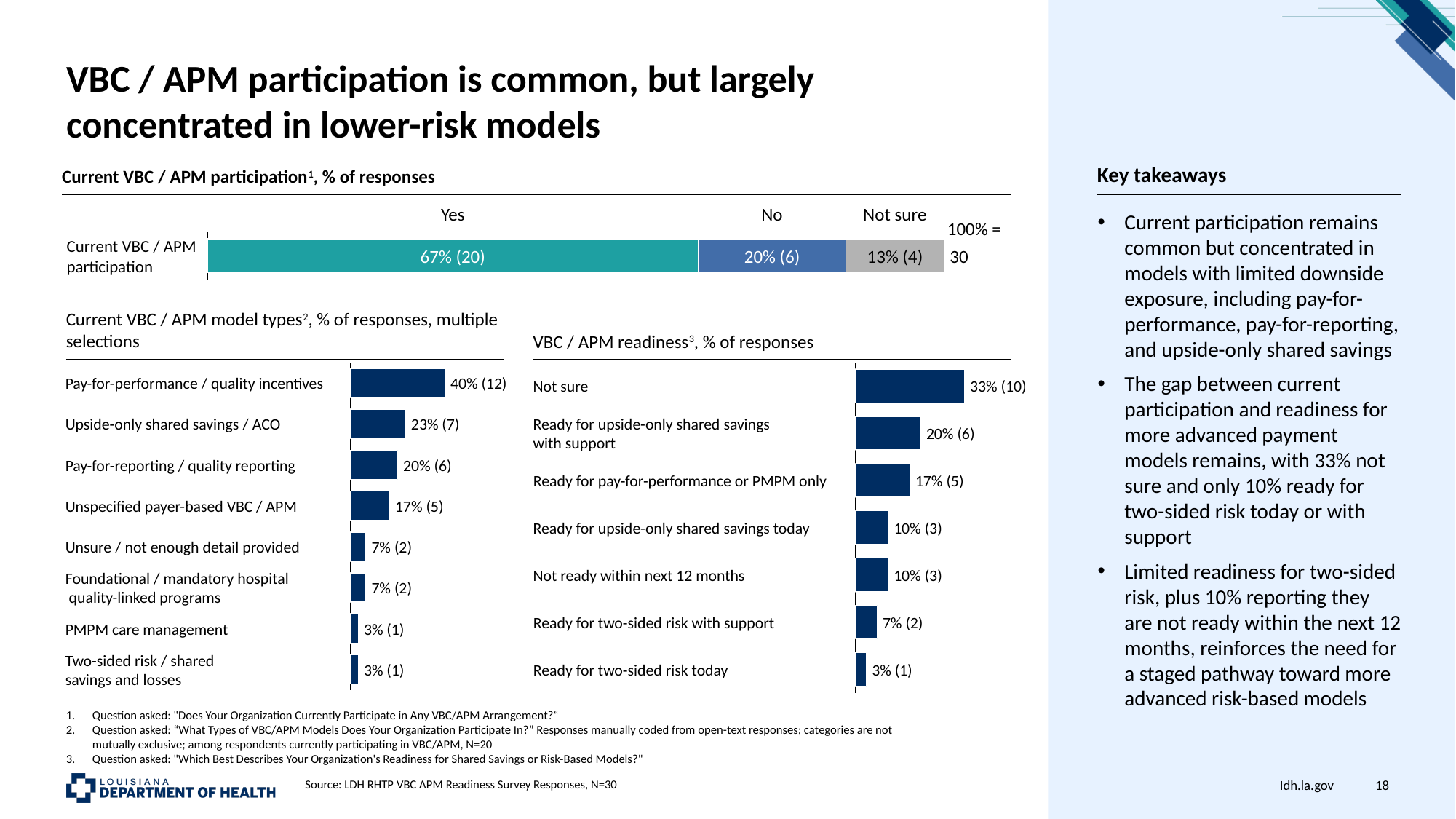
In the 'VBC / APM readiness' chart, which is larger: 'Not sure' or 'Ready for upside-only shared savings with support'? Not sure In the 'Current VBC / APM participation' chart, what is the value for 'Not sure'? 13% (4) In the 'Current VBC / APM model types' chart, which category has the highest value? Pay-for-performance / quality incentives In the 'Current VBC / APM participation' chart, what total does the bar add up to, as shown by the '100% =' label? 30 What type of chart is the 'VBC / APM readiness' chart? Bar chart In the 'Current VBC / APM participation' chart, what percentage of responses answered Yes? 67% (20) In the 'Current VBC / APM model types' chart, what is the value for 'Pay-for-reporting / quality reporting'? 20% (6) In the 'Current VBC / APM model types' chart, what is the difference in percentage points between 'Pay-for-performance / quality incentives' and 'Upside-only shared savings / ACO'? 17 percentage points In the 'Current VBC / APM participation' chart, how many segments make up the stacked bar? 3 In the 'VBC / APM readiness' chart, what is the value for 'Ready for pay-for-performance or PMPM only'? 17% (5) In the 'Current VBC / APM model types' chart, how many categories are plotted? 8 In the 'VBC / APM readiness' chart, which category has the lowest value? Ready for two-sided risk today